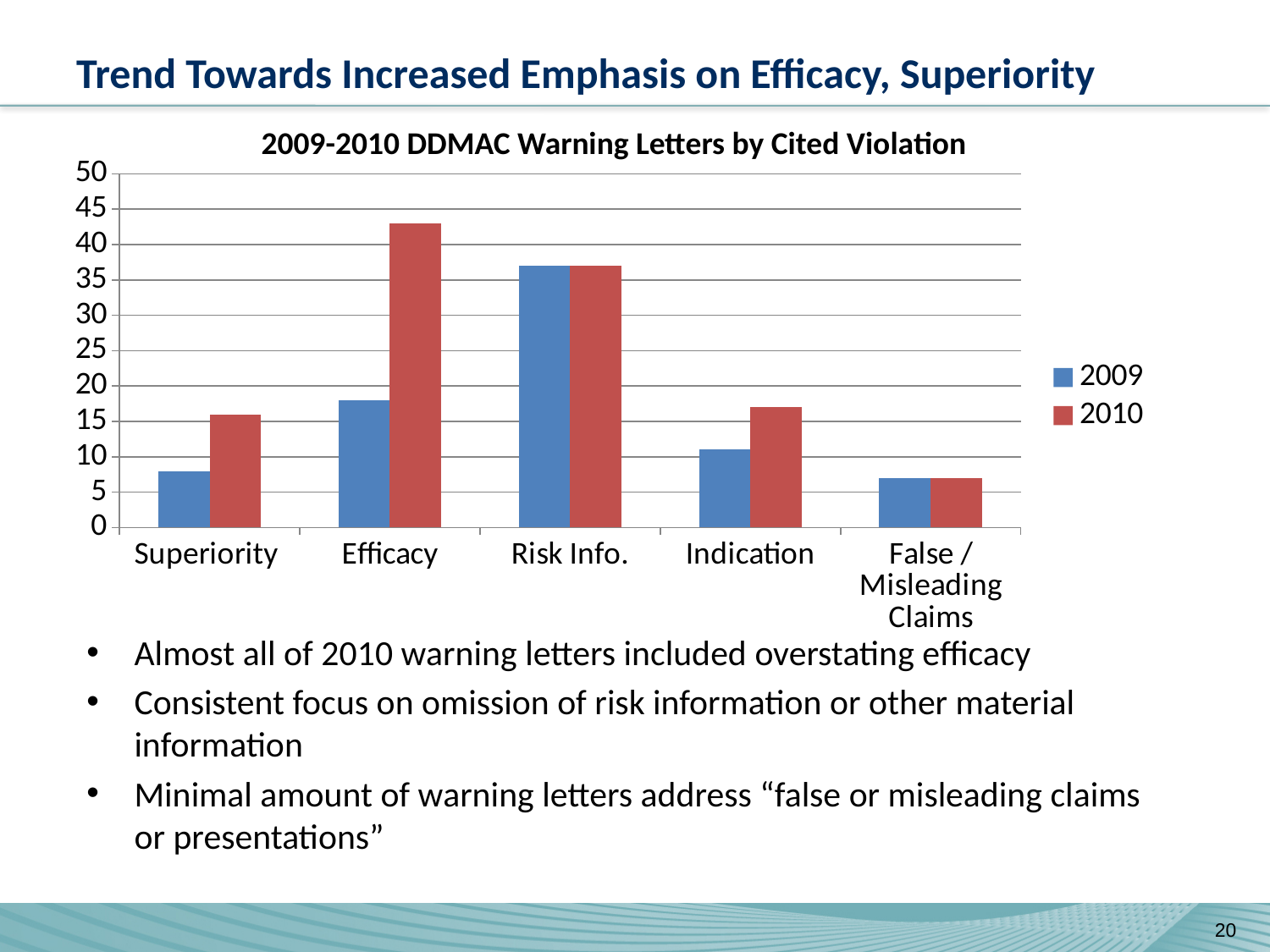
Is the 2010 value for Efficacy greater or less than 40? greater For Superiority, which year has the larger value, 2009 or 2010? 2010 Is the 2010 value for False / Misleading Claims greater or less than 10? less Is the 2009 value for Superiority greater or less than 10? less Which category has the highest value for 2010? Efficacy What is the title of the chart? 2009-2010 DDMAC Warning Letters by Cited Violation What kind of chart is shown on the slide? Bar chart For 2010, which is larger, the value for Efficacy or the value for Risk Info.? Efficacy Which category has the highest value for 2009? Risk Info. How many series does the legend list? 2 Which category has the lowest value for 2010? False / Misleading Claims How many violation categories are shown on the x axis? 5